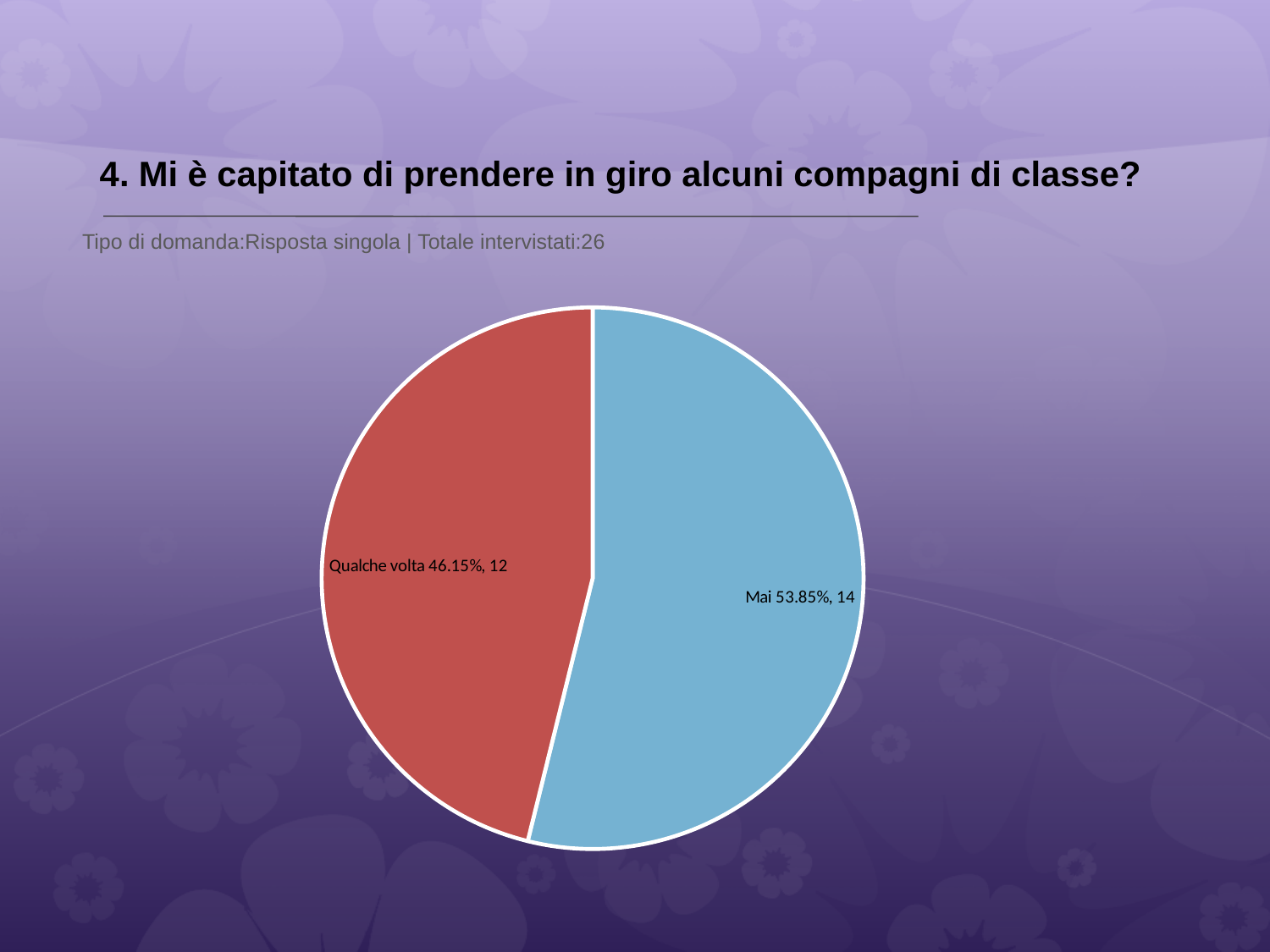
What is the total number of respondents across both slices? 26 What percentage share does the 'Mai' slice have? 53.85% Which slice is the largest in the pie chart? Mai How many slices does the pie chart have? 2 Which has more respondents, 'Mai' or 'Qualche volta'? Mai How many respondents answered 'Mai'? 14 What colour is the 'Mai' slice? blue What percentage share does the 'Qualche volta' slice have? 46.15% Which slice is the smallest in the pie chart? Qualche volta What kind of chart is shown on the slide? pie chart What is the difference in respondent count between 'Mai' and 'Qualche volta'? 2 How many respondents answered 'Qualche volta'? 12